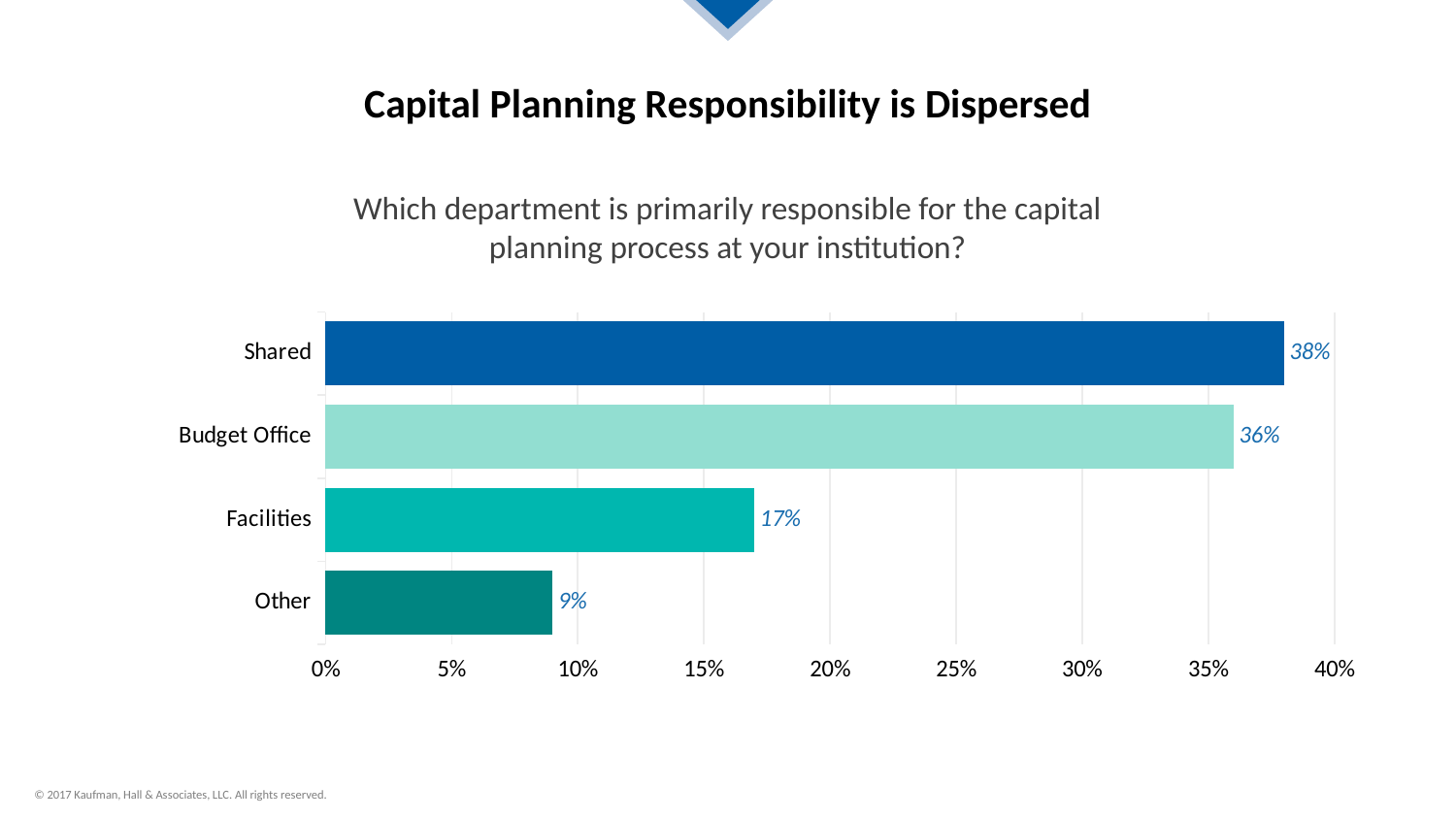
What is the difference between the values for Shared and Budget Office? 2% What is the value for Budget Office? 36% What kind of chart is shown on the slide? Bar chart Which category has the highest value? Shared What is the difference between the values for Facilities and Other? 8% What is the value for Facilities? 17% Which category has the lowest value? Other How many categories are shown in the chart? 4 What percentage of respondents said capital planning responsibility is Shared? 38% What is the value for Other? 9% What is the title of the slide? Capital Planning Responsibility is Dispersed Which is larger, the value for Facilities or the value for Other? Facilities